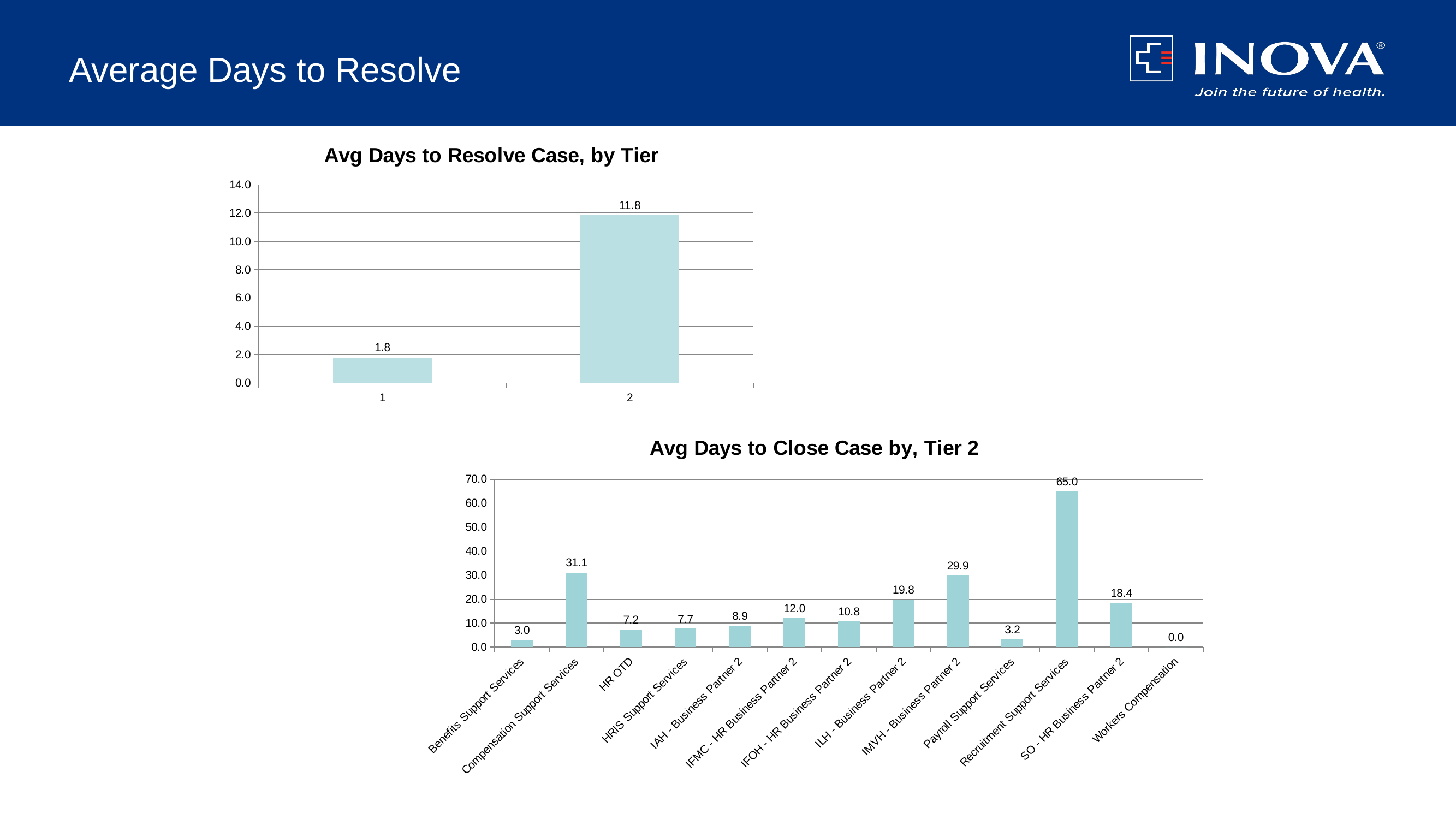
In the 'Avg Days to Close Case by, Tier 2' chart, how many categories are shown on the x axis? 13 In the 'Avg Days to Close Case by, Tier 2' chart, which is larger: ILH - Business Partner 2 or SO - HR Business Partner 2? ILH - Business Partner 2 What kind of chart is 'Avg Days to Close Case by, Tier 2'? Bar chart In the 'Avg Days to Resolve Case, by Tier' chart, what is the value for tier 2? 11.8 In the 'Avg Days to Close Case by, Tier 2' chart, what is the value for IMVH - Business Partner 2? 29.9 In the 'Avg Days to Close Case by, Tier 2' chart, which category has the highest value? Recruitment Support Services In the 'Avg Days to Resolve Case, by Tier' chart, what is the value for tier 1? 1.8 In the 'Avg Days to Close Case by, Tier 2' chart, what is the value for Compensation Support Services? 31.1 In the 'Avg Days to Resolve Case, by Tier' chart, what is the difference between tier 2 and tier 1? 10.0 In the 'Avg Days to Resolve Case, by Tier' chart, how many categories are shown? 2 In the 'Avg Days to Close Case by, Tier 2' chart, which category has the lowest value? Workers Compensation In the 'Avg Days to Close Case by, Tier 2' chart, what is the difference between Recruitment Support Services and Compensation Support Services? 33.9